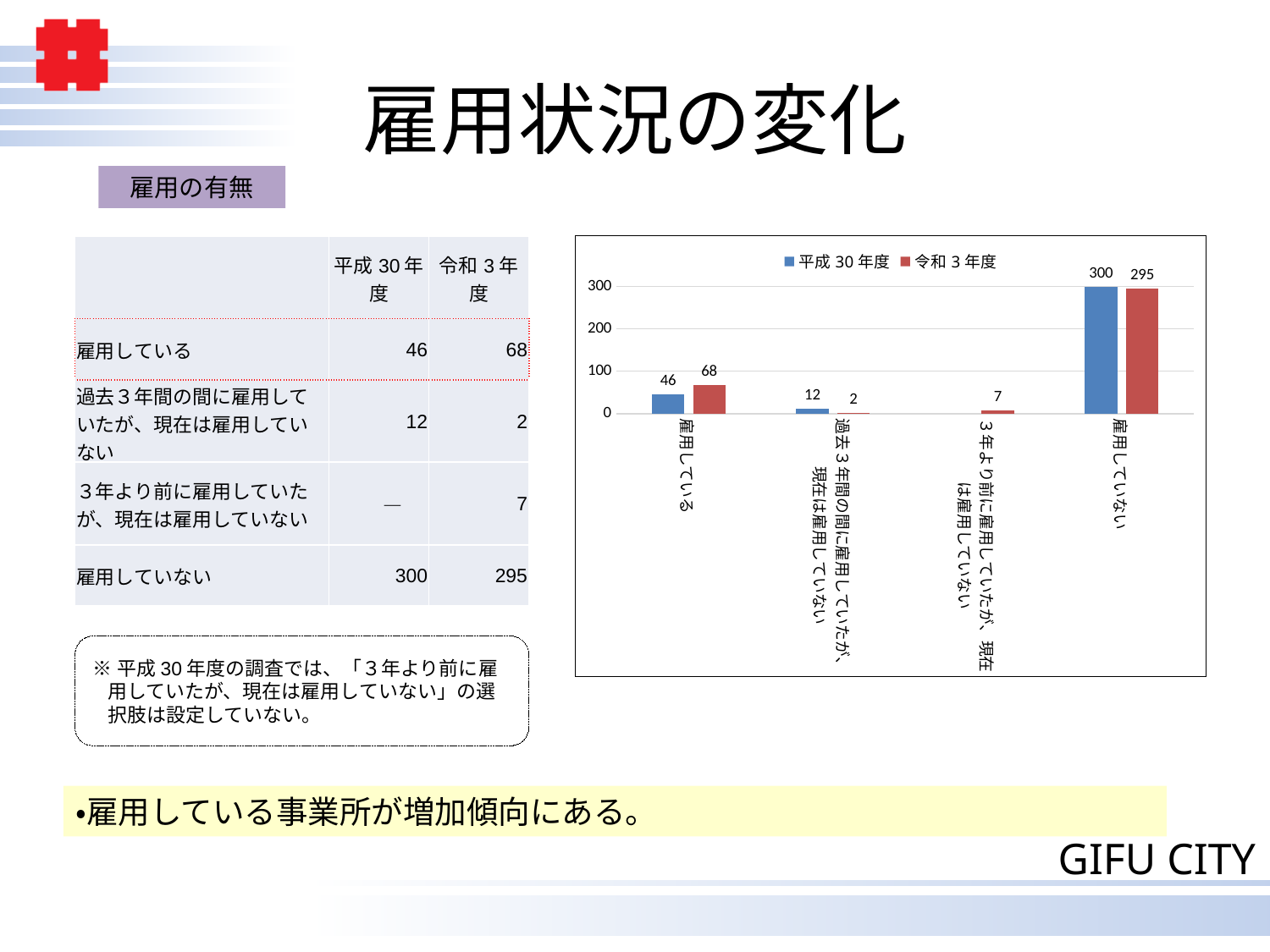
What is the value for 雇用している in the 平成30年度 series? 46 Which series is shown in red in the chart? 令和3年度 Which category has the lowest value in the 令和3年度 series? 過去3年間の間に雇用していたが、現在は雇用していない What is the value for 雇用していない in the 令和3年度 series? 295 What type of chart is shown on the slide? bar chart What is the value for 雇用している in the 令和3年度 series? 68 Which category has the highest value in the 平成30年度 series? 雇用していない For 過去3年間の間に雇用していたが、現在は雇用していない, which series has the larger value, 平成30年度 or 令和3年度? 平成30年度 What is the difference between the 令和3年度 and 平成30年度 values for 雇用している? 22 How many series does the chart legend list? 2 What is the value for 3年より前に雇用していたが、現在は雇用していない in the 令和3年度 series? 7 How many categories are shown on the x axis of the chart? 4